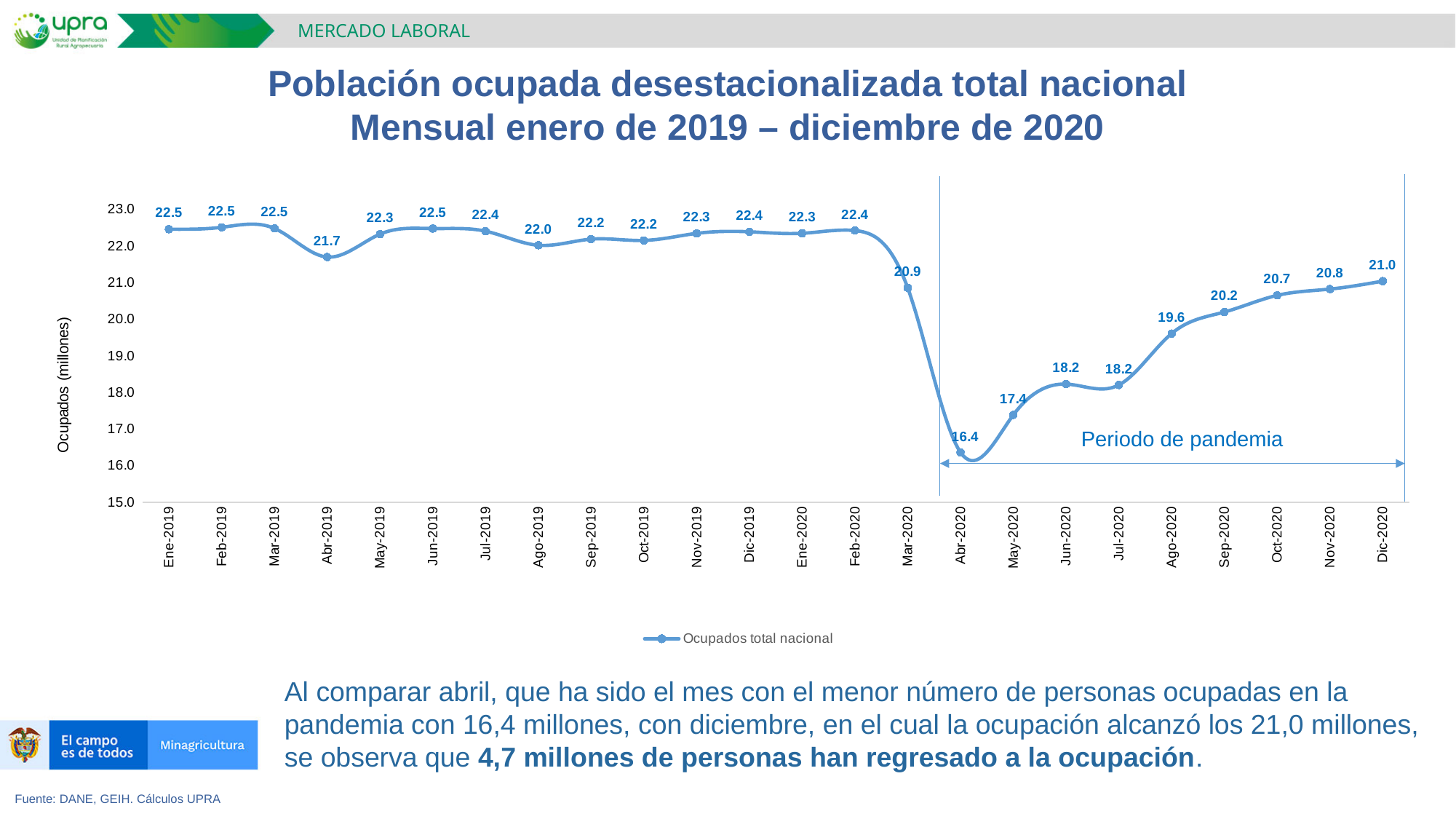
Which is larger, the value for Ago-2020 or the value for Sep-2020? Sep-2020 What is the difference between the values for Feb-2020 and Mar-2020? 1.5 What is the value for Abr-2019? 21.7 What is the value for Dic-2020? 21.0 What is the difference between the values for Mar-2019 and Abr-2019? 0.8 What is the value for Mar-2020? 20.9 Is the value for Abr-2020 greater or less than 17.0? less What is the value for Abr-2020? 16.4 Do the values rise or fall from Abr-2020 to Dic-2020? rise How many months are plotted on the chart? 24 Which month has the lowest value? Abr-2020 What kind of chart is shown? line chart